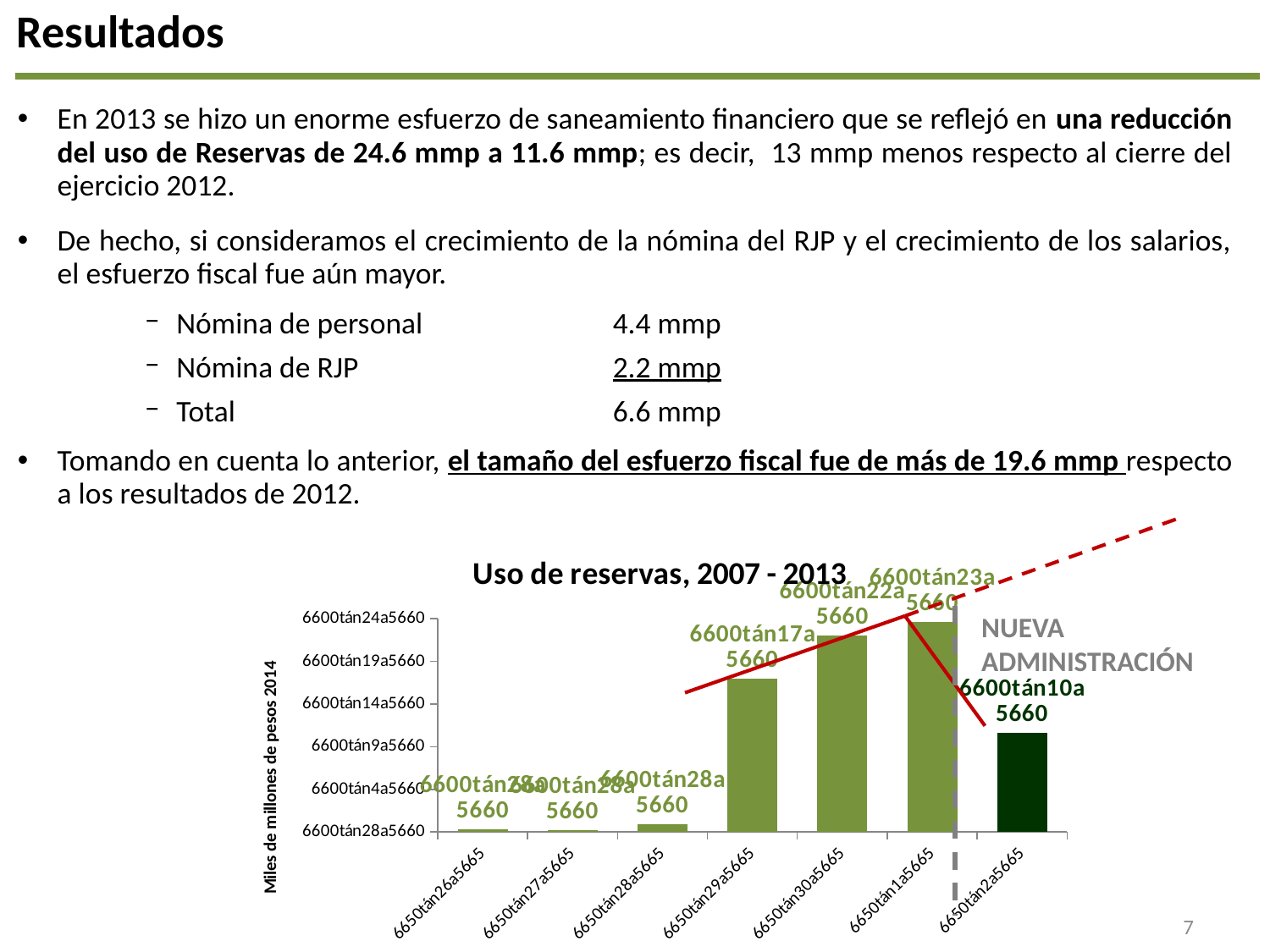
What is the label on the vertical axis of the chart? Miles de millones de pesos 2014 How many bars does the chart contain? 7 Is the fourth bar from the left taller or shorter than the fifth bar? Shorter Which bar is the tallest in the chart, counting from the left? The sixth bar Do the bar values rise or fall from the first bar to the sixth bar? Rise Is the sixth bar from the left taller or shorter than the seventh (last) bar? Taller Does the value fall or rise from the sixth bar to the last bar? Fall Is the third bar from the left taller or shorter than the fourth bar? Shorter What kind of chart is shown on the slide? Bar chart What is the title of the chart? Uso de reservas, 2007 - 2013